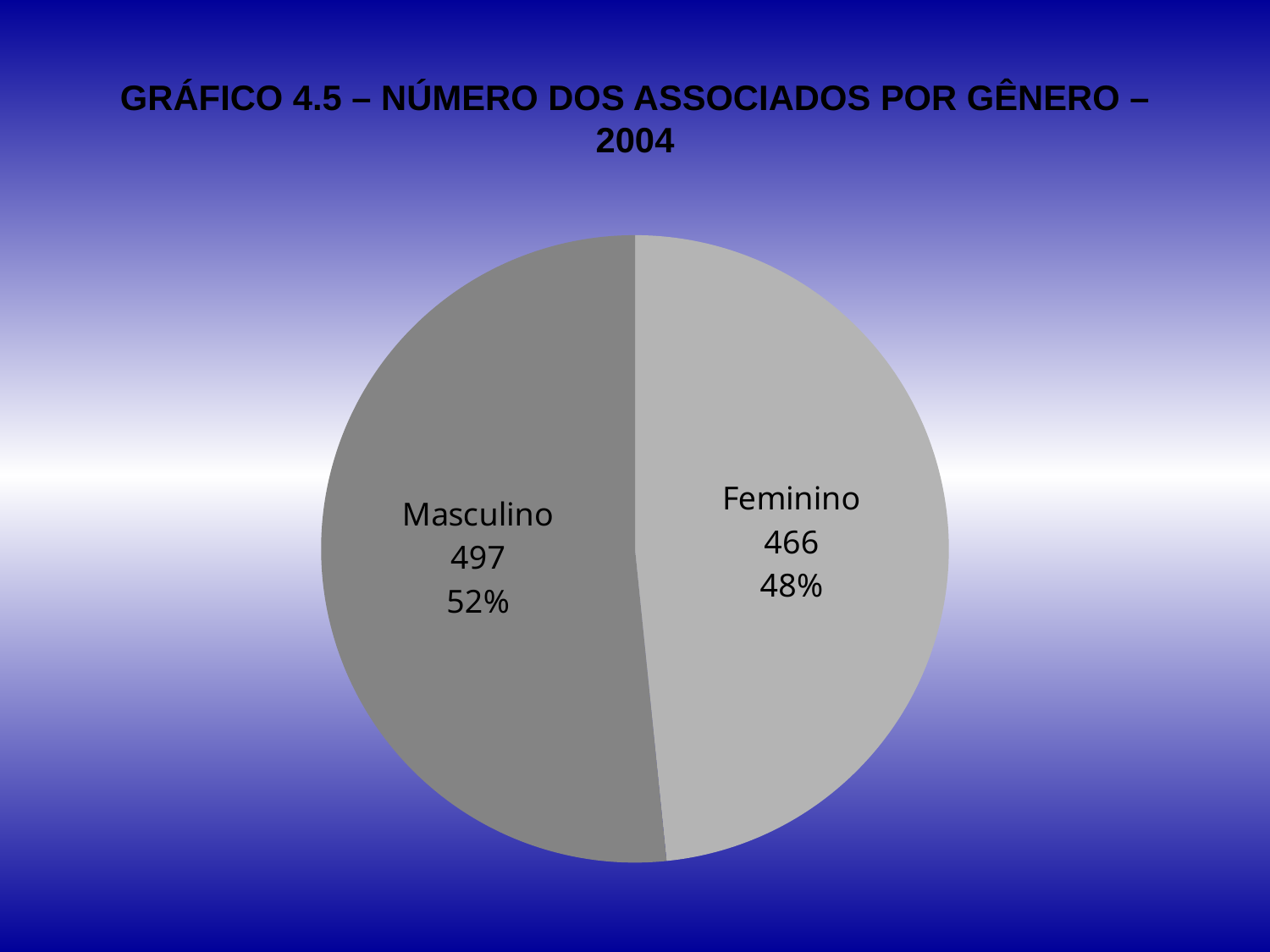
What percentage share does the Masculino slice represent? 52% What year does the chart title refer to? 2004 Which gender has the larger number of associates? Masculino What is the number of associates for Feminino? 466 Is the value for Masculino larger or smaller than the value for Feminino? larger What is the total number of associates across both slices? 963 How many slices does the pie chart have? 2 What percentage share does the Feminino slice represent? 48% What kind of chart is shown on the slide? pie chart Which gender has the smaller number of associates? Feminino What is the number of associates for Masculino? 497 What is the difference between the Masculino and Feminino values? 31